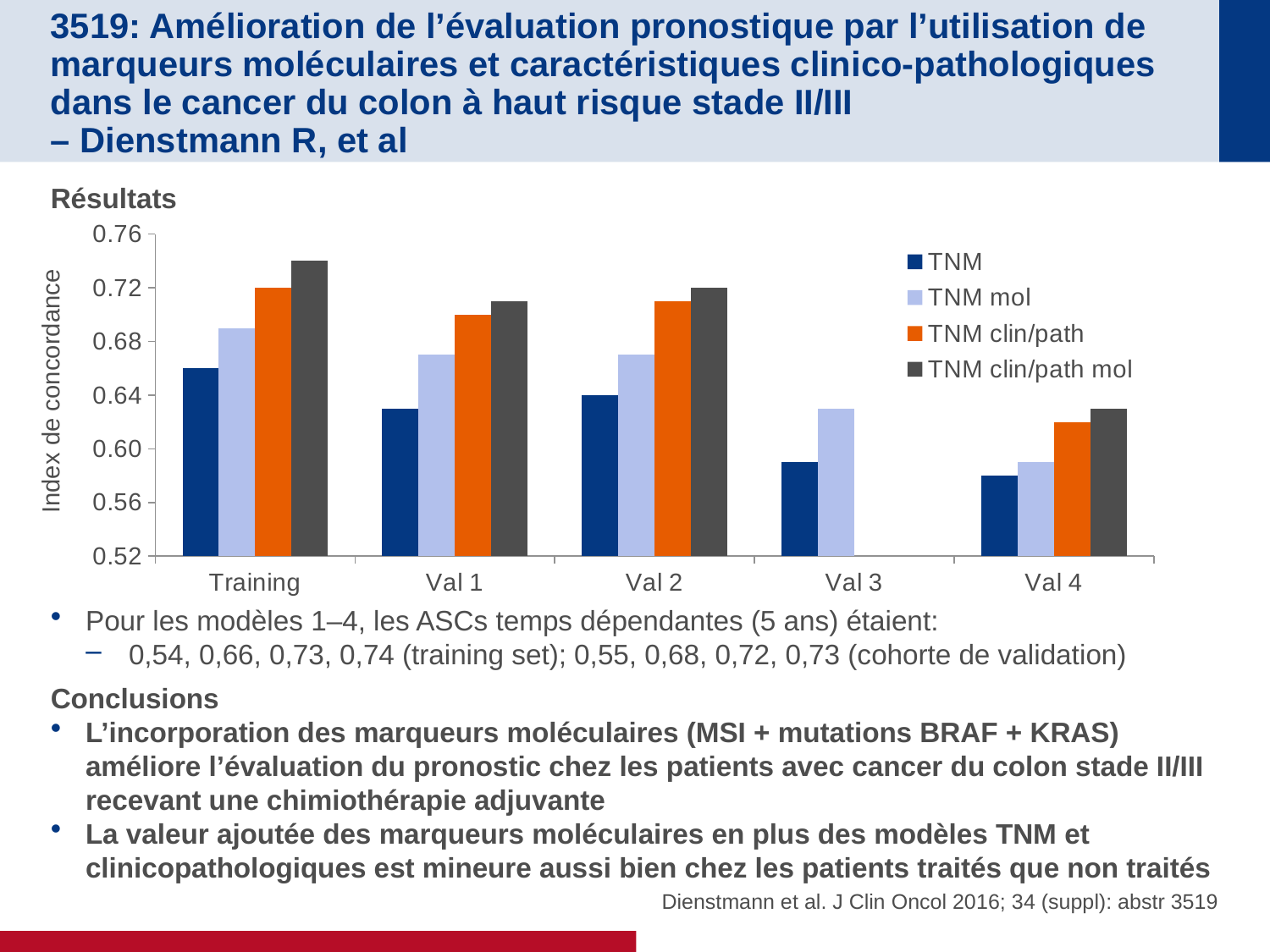
How many series does the chart legend list? 4 What is the label of the y axis of the chart? Index de concordance Which category has the highest value for the TNM clin/path mol series? Training Which series are listed in the chart legend? TNM, TNM mol, TNM clin/path, TNM clin/path mol Which category has the lowest value for the TNM series? Val 4 Is the TNM clin/path mol value for Training greater or less than 0.72? greater How many categories are shown on the x axis of the chart? 5 Do the TNM values generally rise or fall from Training to Val 4 along the x axis? fall What kind of chart is shown on the slide? bar chart Which is larger, the TNM value for Training or the TNM value for Val 4? Training Is the TNM clin/path value for Val 4 greater or less than 0.64? less Is the TNM value for Val 3 greater or less than 0.60? less